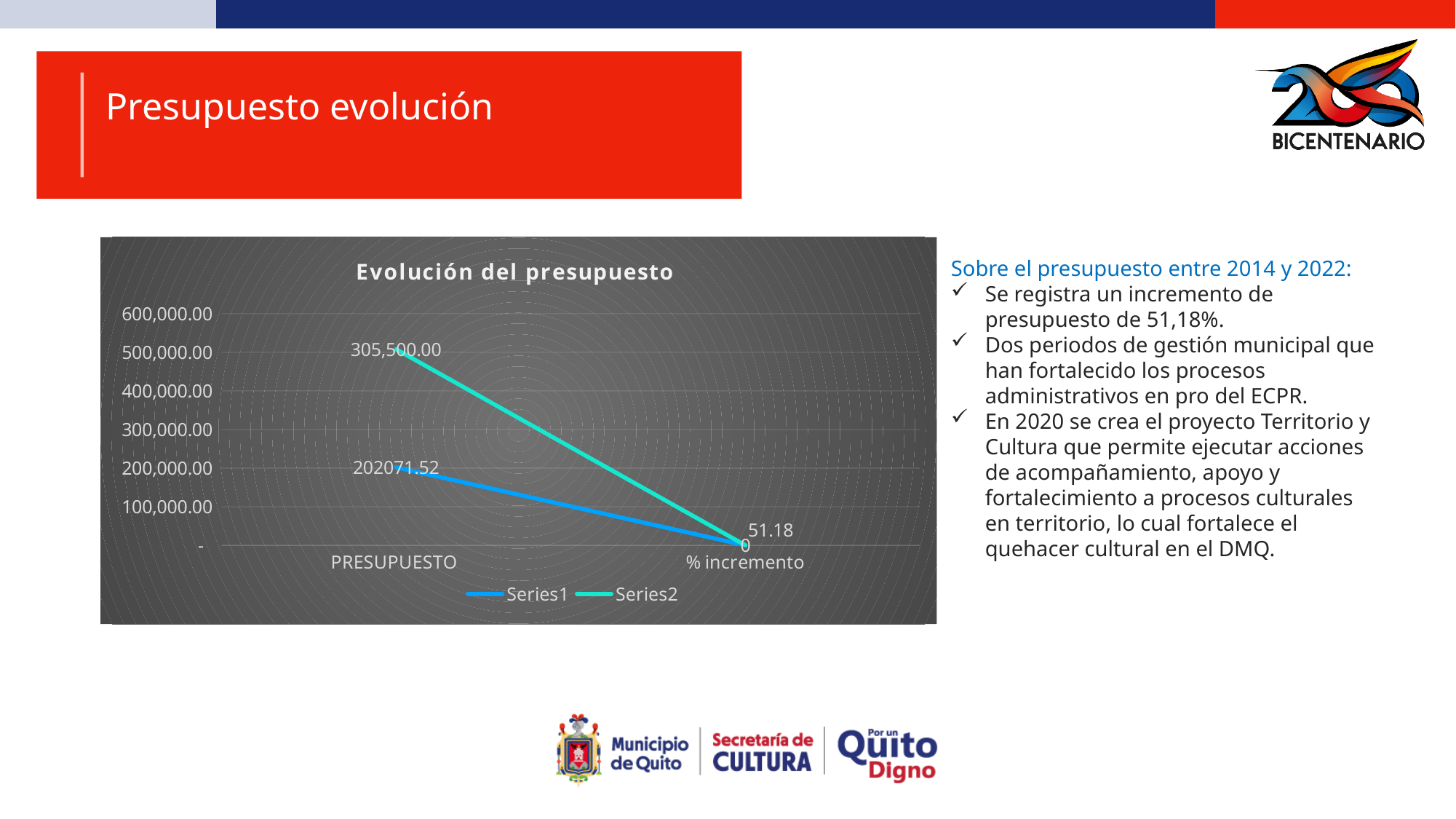
What is the title of the chart? Evolución del presupuesto Which series has the larger value for PRESUPUESTO, Series1 or Series2? Series2 What are the two entries listed in the chart's legend? Series1 and Series2 What is the value of Series2 for PRESUPUESTO? 305,500.00 What is the value of Series2 for % incremento? 51.18 Does the Series2 line rise or fall from PRESUPUESTO to % incremento? fall What kind of chart is shown on the slide? line chart What is the value of Series1 for PRESUPUESTO? 202071.52 How many categories are shown on the x axis of the chart? 2 How many series does the legend of the chart list? 2 What is the value of Series1 for % incremento? 0 What is the difference between the Series2 and Series1 values for PRESUPUESTO? 103,428.48